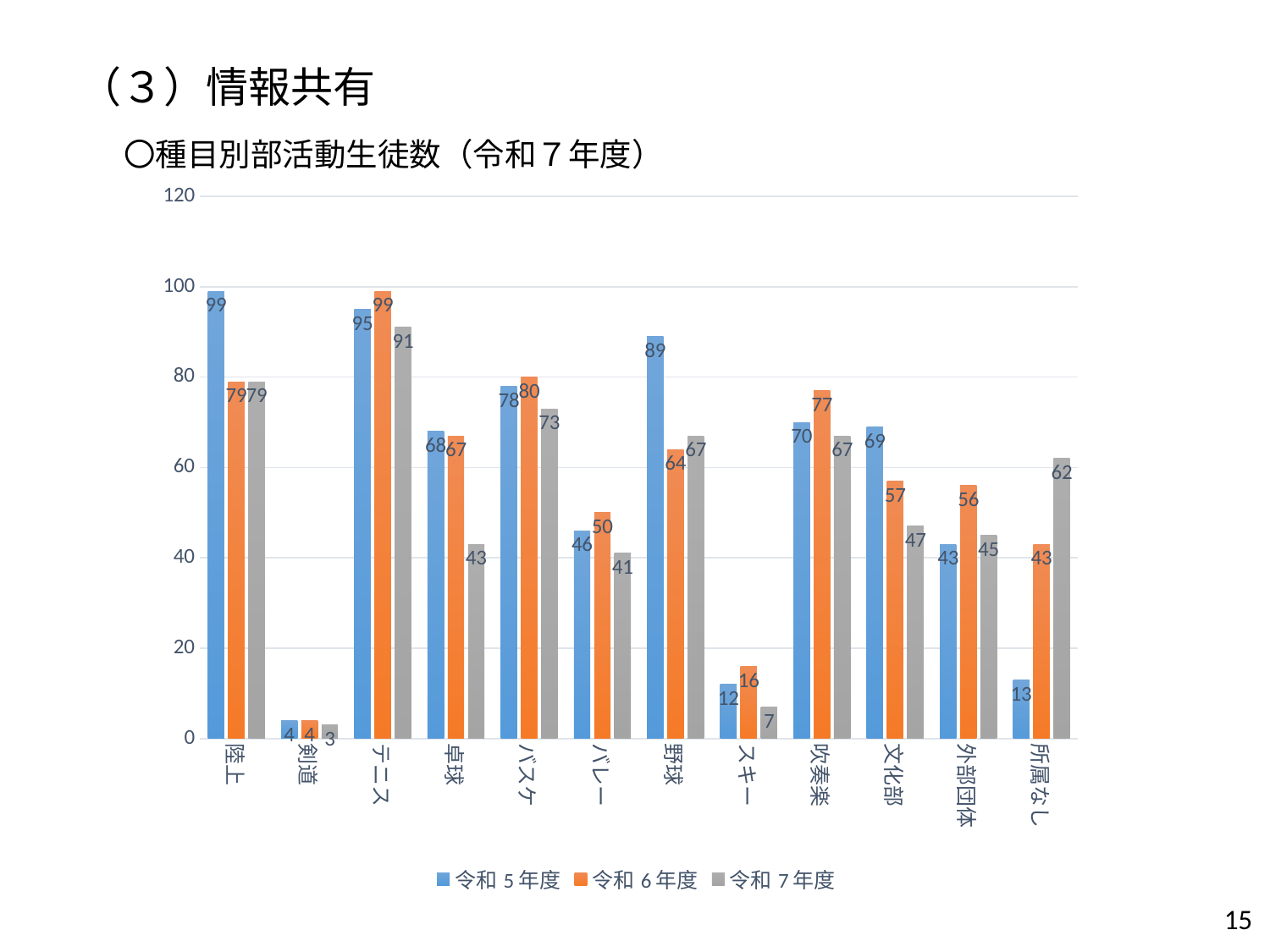
What is the difference between the 令和５年度 and 令和７年度 values for 所属なし? 49 Which category has the highest value in the 令和７年度 series? テニス What is the value for 卓球 in the 令和７年度 series? 43 How many series does the legend list? 3 What is the value for 所属なし in the 令和６年度 series? 43 How many categories are shown on the x axis? 12 Do the values for 所属なし rise or fall from 令和５年度 to 令和７年度? rise What is the value for 野球 in the 令和５年度 series? 89 Which category has the lowest value in the 令和５年度 series? 剣道 Which is larger for 吹奏楽: the 令和６年度 value or the 令和７年度 value? 令和６年度 What is the title of the chart? 種目別部活動生徒数（令和７年度） What kind of chart is shown on the slide? bar chart